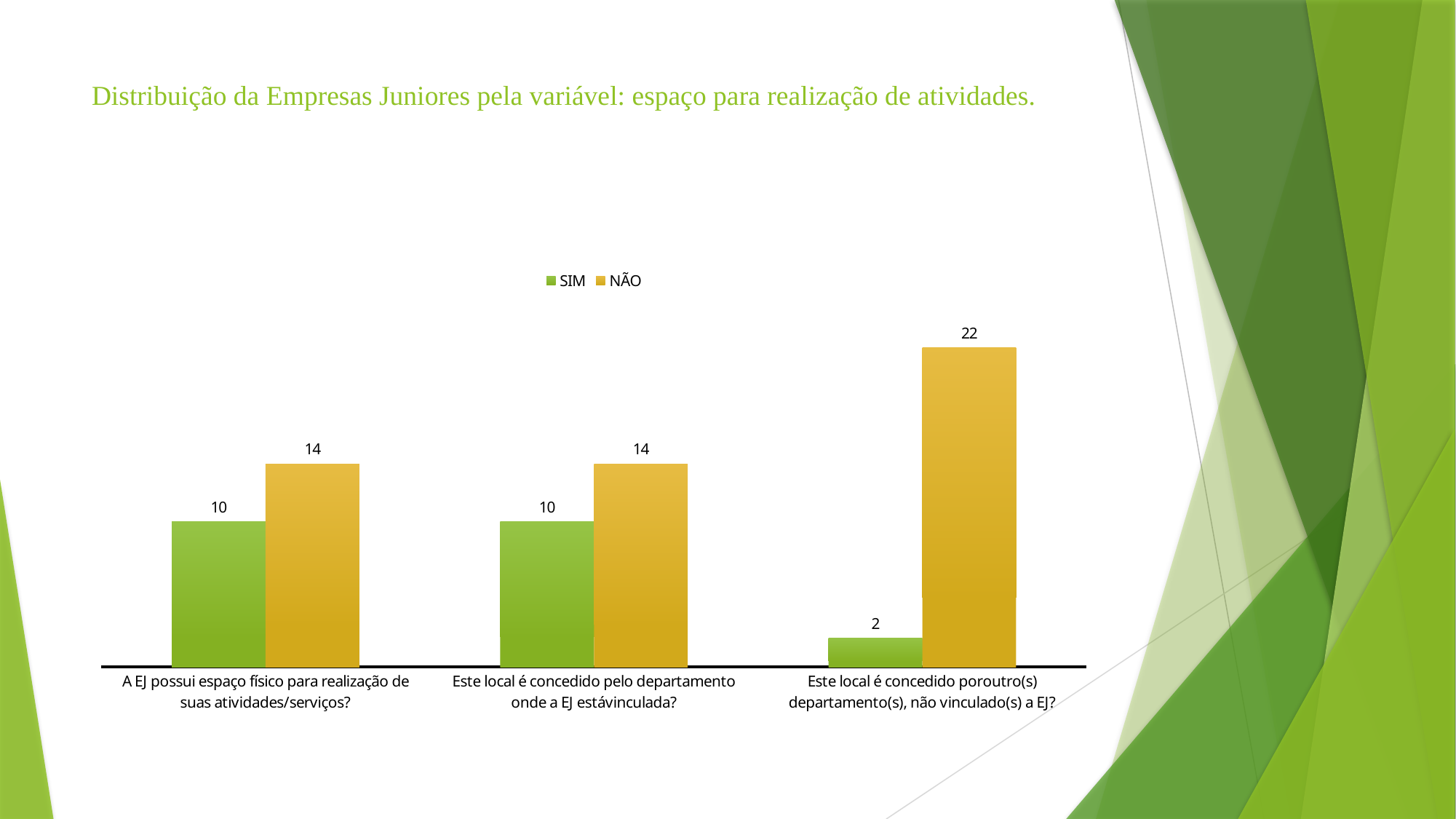
How many categories are shown on the x axis? 3 How many series does the legend list? 2 Which category has the highest NÃO value? Este local é concedido por outro(s) departamento(s), não vinculado(s) a EJ? What is the NÃO value for "A EJ possui espaço físico para realização de suas atividades/serviços?"? 14 Which category has the lowest SIM value? Este local é concedido por outro(s) departamento(s), não vinculado(s) a EJ? What is the NÃO value for "Este local é concedido por outro(s) departamento(s), não vinculado(s) a EJ?"? 22 What is the SIM value for "Este local é concedido por outro(s) departamento(s), não vinculado(s) a EJ?"? 2 Which colour represents the NÃO series? Orange/gold What is the SIM value for "A EJ possui espaço físico para realização de suas atividades/serviços?"? 10 What is the difference between the NÃO and SIM values for "Este local é concedido por outro(s) departamento(s), não vinculado(s) a EJ?"? 20 For "Este local é concedido pelo departamento onde a EJ está vinculada?", which is larger, SIM or NÃO? NÃO What kind of chart is shown on the slide? Bar chart